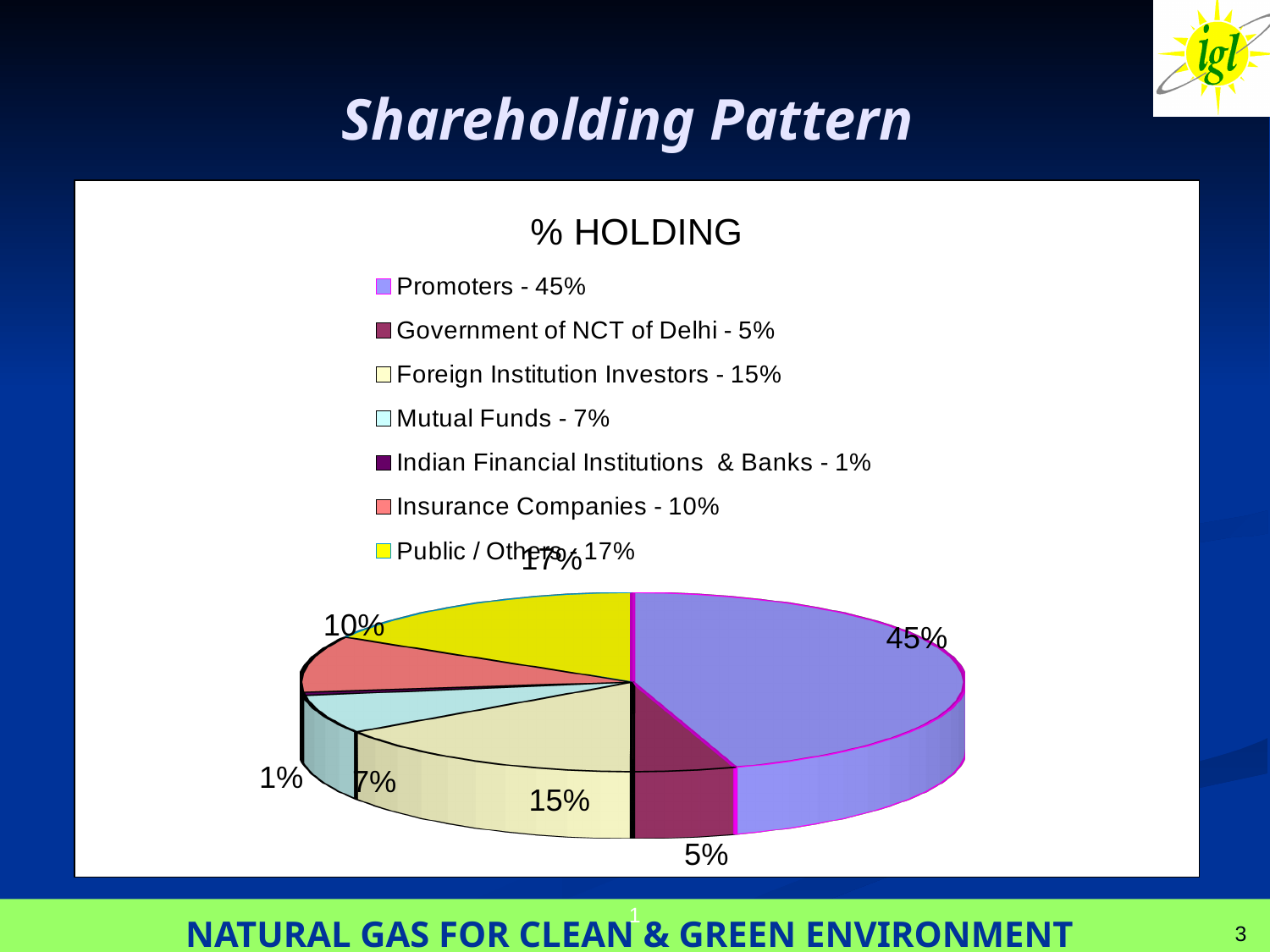
What percentage of holding is held by Mutual Funds? 7% What is the share of the Government of NCT of Delhi? 5% What percentage of holding is held by Promoters? 45% How many categories does the pie chart show? 7 What kind of chart is shown on the slide? pie chart Which category holds the smallest share of the pie? Indian Financial Institutions & Banks Which category holds the largest share of the pie? Promoters What is the difference between the Promoters share and the Public / Others share? 28% What percentage of holding is held by Insurance Companies? 10% Which is larger, the share for Insurance Companies or the share for Mutual Funds? Insurance Companies What percentage of holding is held by Foreign Institution Investors? 15% What is the chart's title? % HOLDING